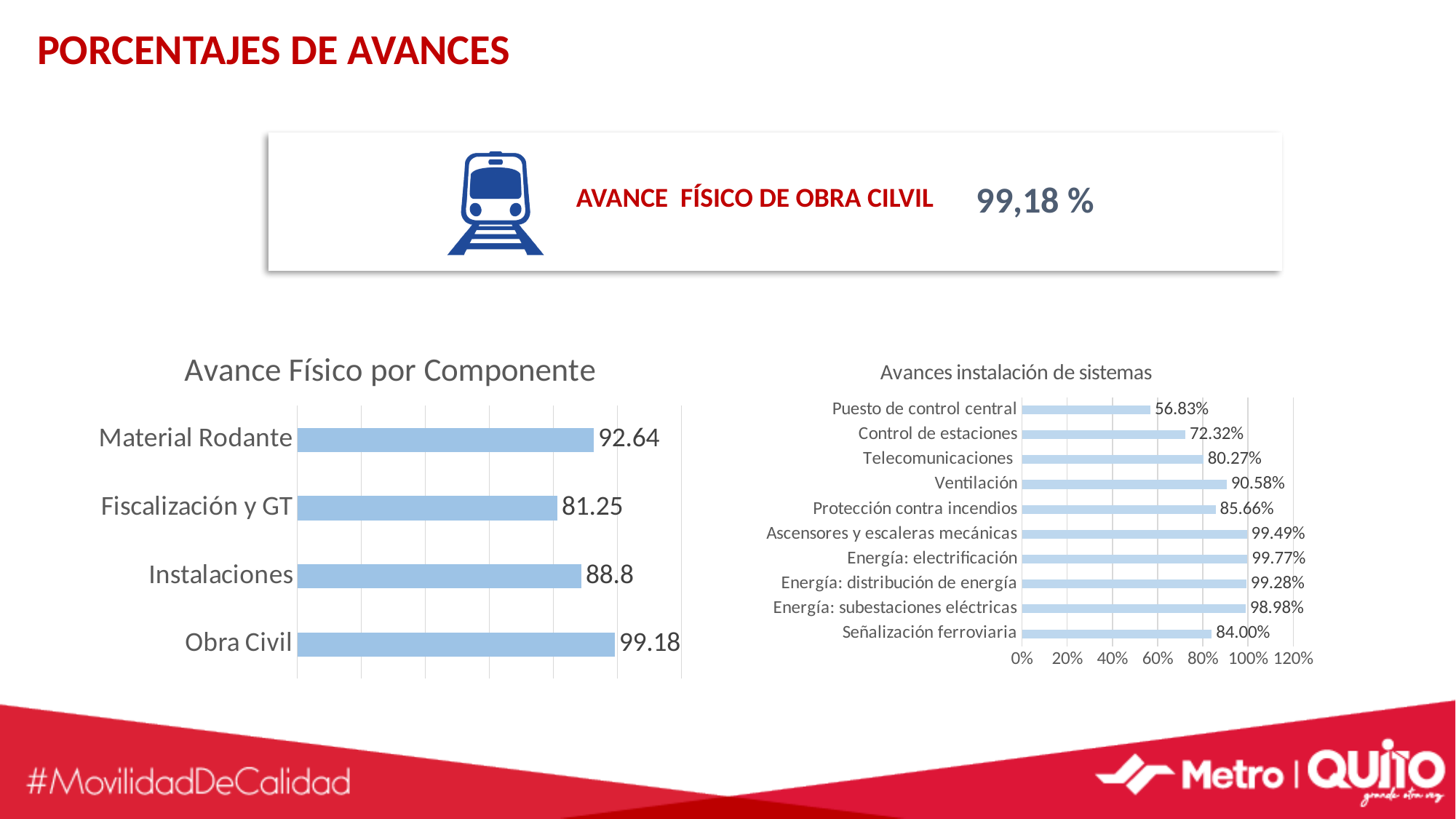
In the 'Avance Físico por Componente' chart, which component has the highest value? Obra Civil In the 'Avances instalación de sistemas' chart, what is the difference between Control de estaciones and Puesto de control central? 15.49% What kind of chart is 'Avance Físico por Componente'? Bar chart In the 'Avance Físico por Componente' chart, how many components are shown? 4 In the 'Avance Físico por Componente' chart, which component has the lowest value? Fiscalización y GT In the 'Avances instalación de sistemas' chart, which is larger: Ventilación or Protección contra incendios? Ventilación In the 'Avances instalación de sistemas' chart, how many systems are listed? 10 In the 'Avances instalación de sistemas' chart, which system has the lowest value? Puesto de control central In the 'Avances instalación de sistemas' chart, what is the value for Telecomunicaciones? 80.27% In the 'Avances instalación de sistemas' chart, which system has the highest value? Energía: electrificación In the 'Avance Físico por Componente' chart, what is the difference between Obra Civil and Instalaciones? 10.38 In the 'Avance Físico por Componente' chart, what is the value for Material Rodante? 92.64